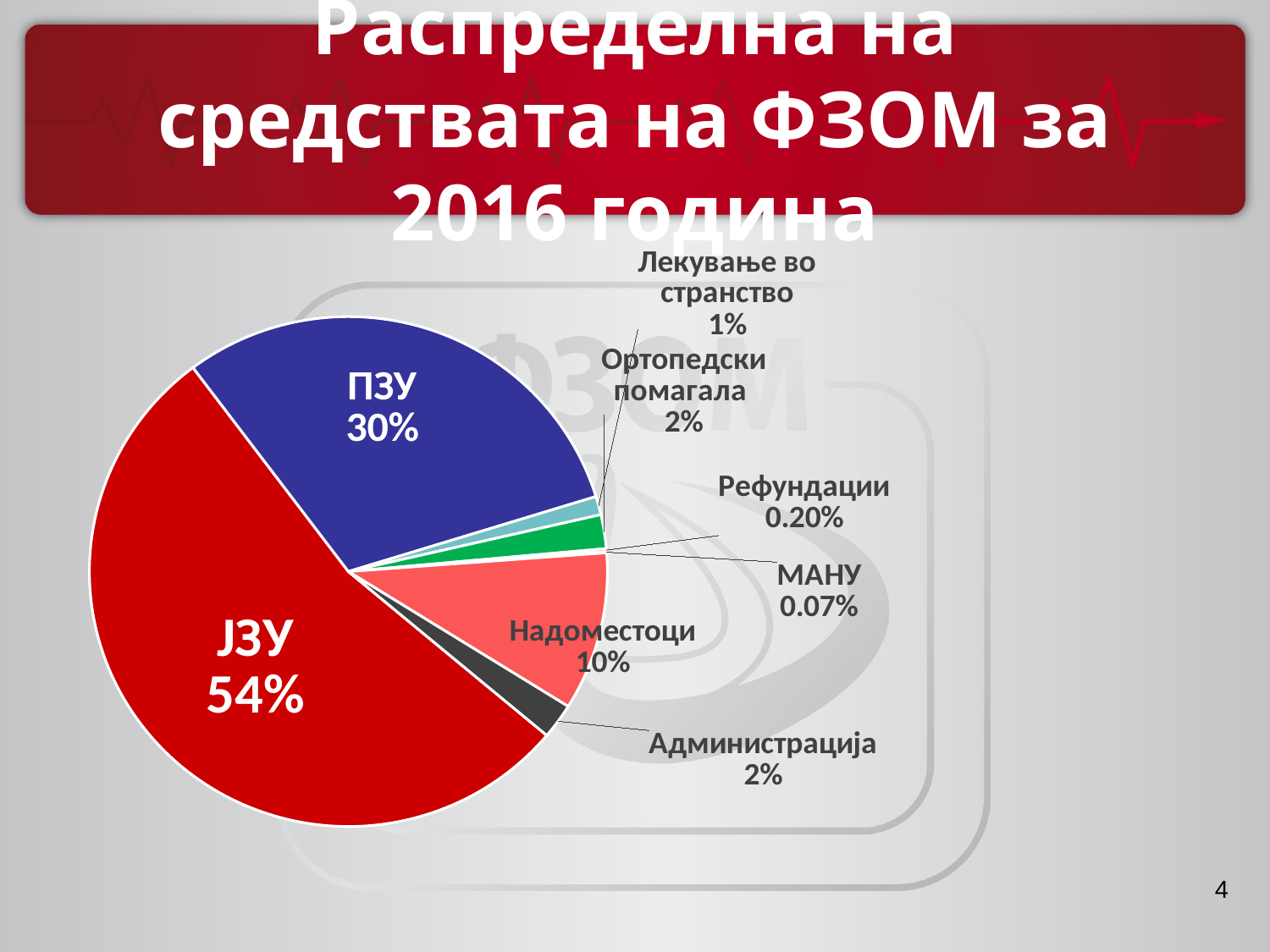
What is the value shown for Надоместоци? 10% What is the difference in percentage points between ЈЗУ and ПЗУ? 24 What share of the pie does ЈЗУ have? 54% What is the value shown for Рефундации? 0.20% What share of the pie does ПЗУ have? 30% Which category has the largest slice of the pie? ЈЗУ Which category has the smallest slice of the pie? МАНУ What is the value shown for МАНУ? 0.07% What is the value shown for Лекување во странство? 1% What kind of chart is shown on the slide? pie chart How many slices does the pie chart have? 8 Which is larger, the share for Надоместоци or the share for Администрација? Надоместоци